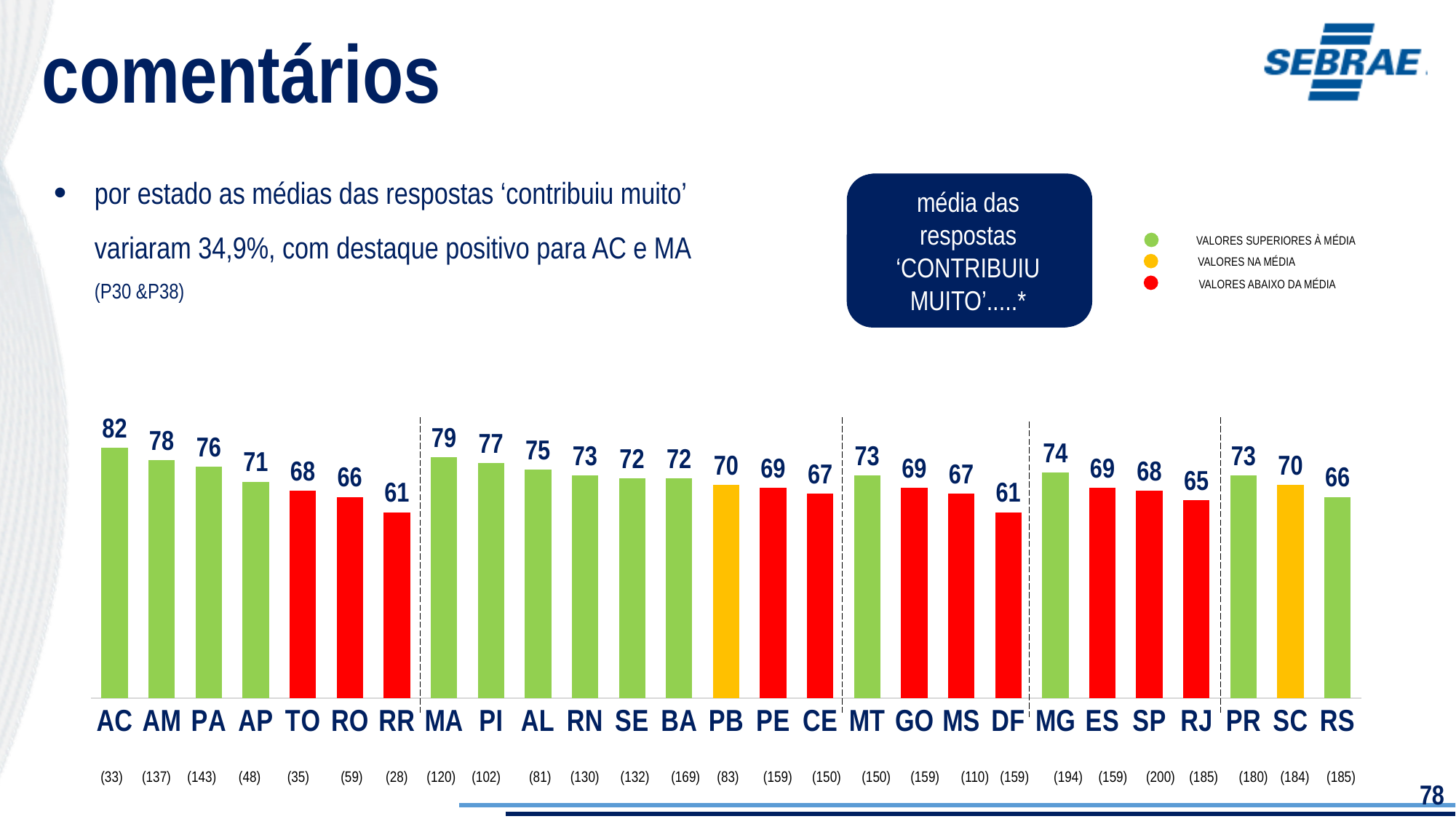
Which has a larger value, RR or SC? SC Which has a larger value, PI or PR? PI What is the difference between the values for AC and AM? 4 What is the difference between the values for MG and RJ? 9 What kind of chart is shown on the slide? bar chart What is the value shown for AC? 82 How many states (bars) are shown in the chart? 27 Which state has the highest value in the chart? AC What is the lowest value shown in the chart? 61 What colour are the bars for values below the average (valores abaixo da média)? red What is the value shown for DF? 61 What is the value shown for MA? 79